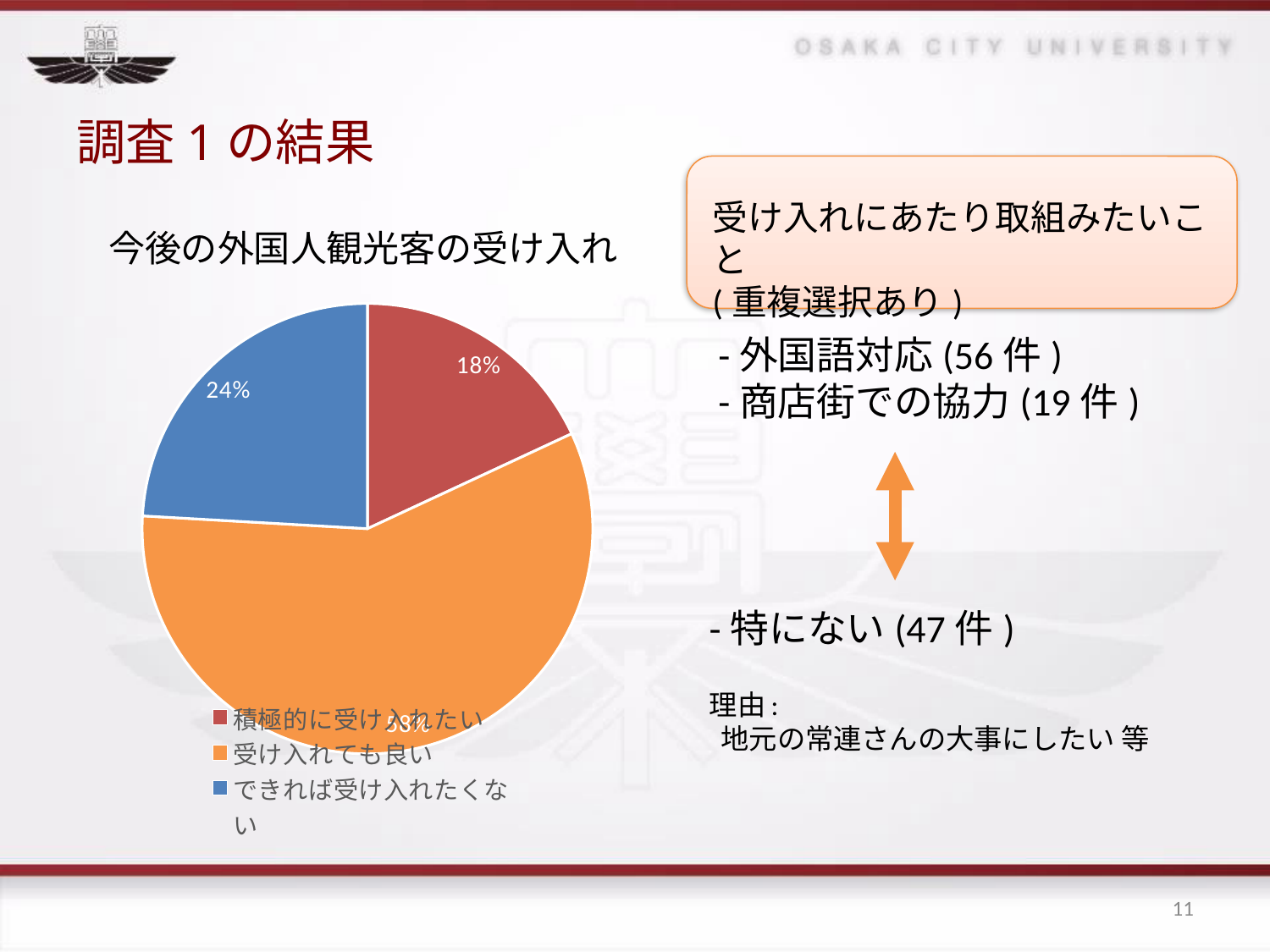
What percentage of the pie is 受け入れても良い? 58% What percentage of the pie is できれば受け入れたくない? 24% Which category has the largest share of the pie? 受け入れても良い How many slices does the pie chart have? 3 What percentage of the pie is 積極的に受け入れたい? 18% What colour is the slice for 受け入れても良い? orange How many entries does the pie chart's legend list? 3 Which is larger: the share for できれば受け入れたくない or the share for 積極的に受け入れたい? できれば受け入れたくない What is the difference in percentage points between できれば受け入れたくない and 積極的に受け入れたい? 6 What kind of chart is shown on the slide? pie chart What is the title of the pie chart? 今後の外国人観光客の受け入れ Which category has the smallest share of the pie? 積極的に受け入れたい